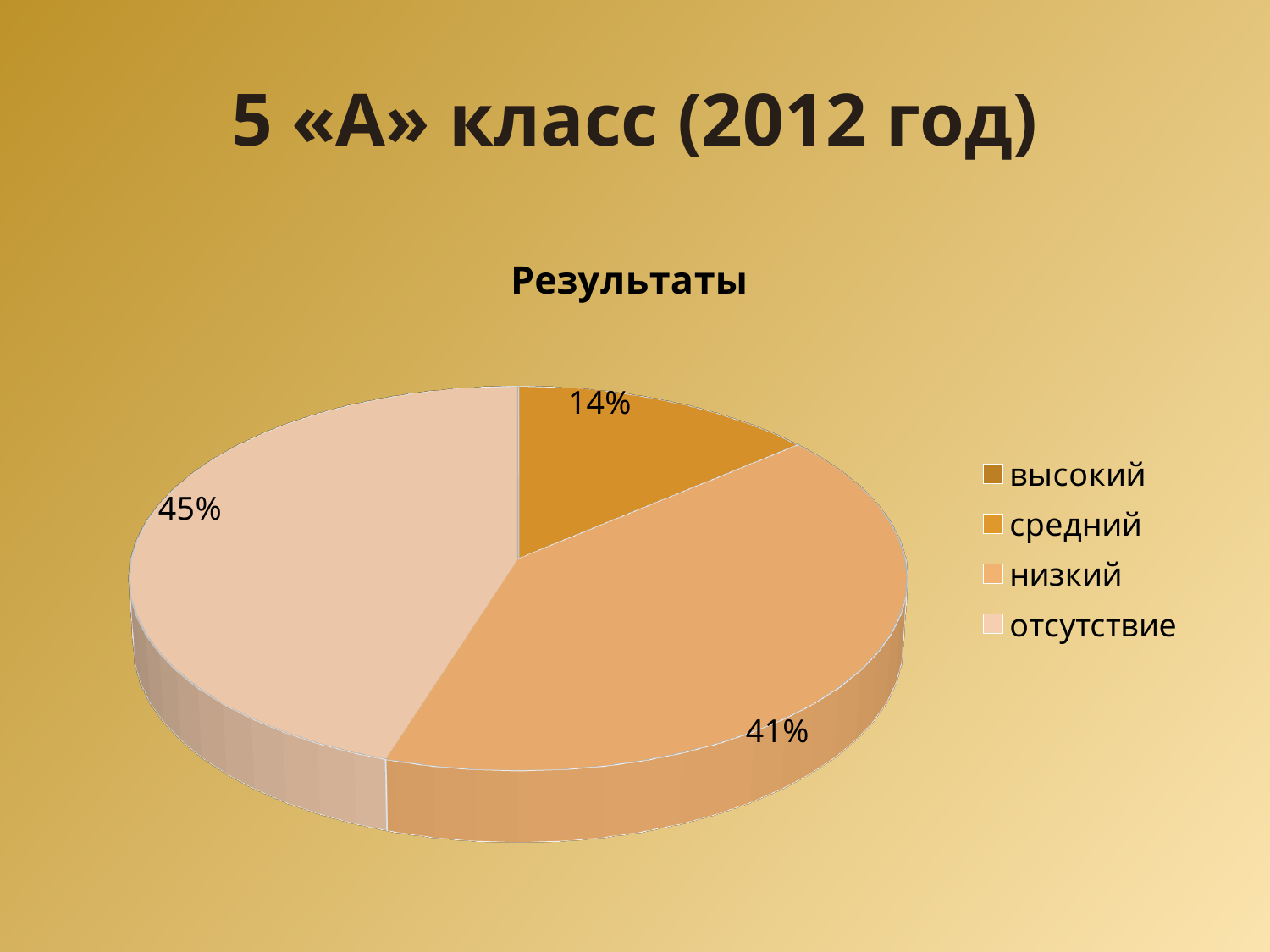
Which of the labelled slices is the smallest? средний Which legend entry is listed first? высокий How many entries does the chart legend list? 4 What is the title of the chart? Результаты How many slices with percentage labels are visible in the pie? 3 What share of the pie does the 'низкий' slice take? 41% What is the difference between the 'отсутствие' share and the 'низкий' share? 4% Which category has the largest slice of the pie? отсутствие What share of the pie does the 'средний' slice take? 14% What share of the pie does the 'отсутствие' slice take? 45% What type of chart is shown on the slide? pie chart Which is larger, the 'низкий' slice or the 'средний' slice? низкий